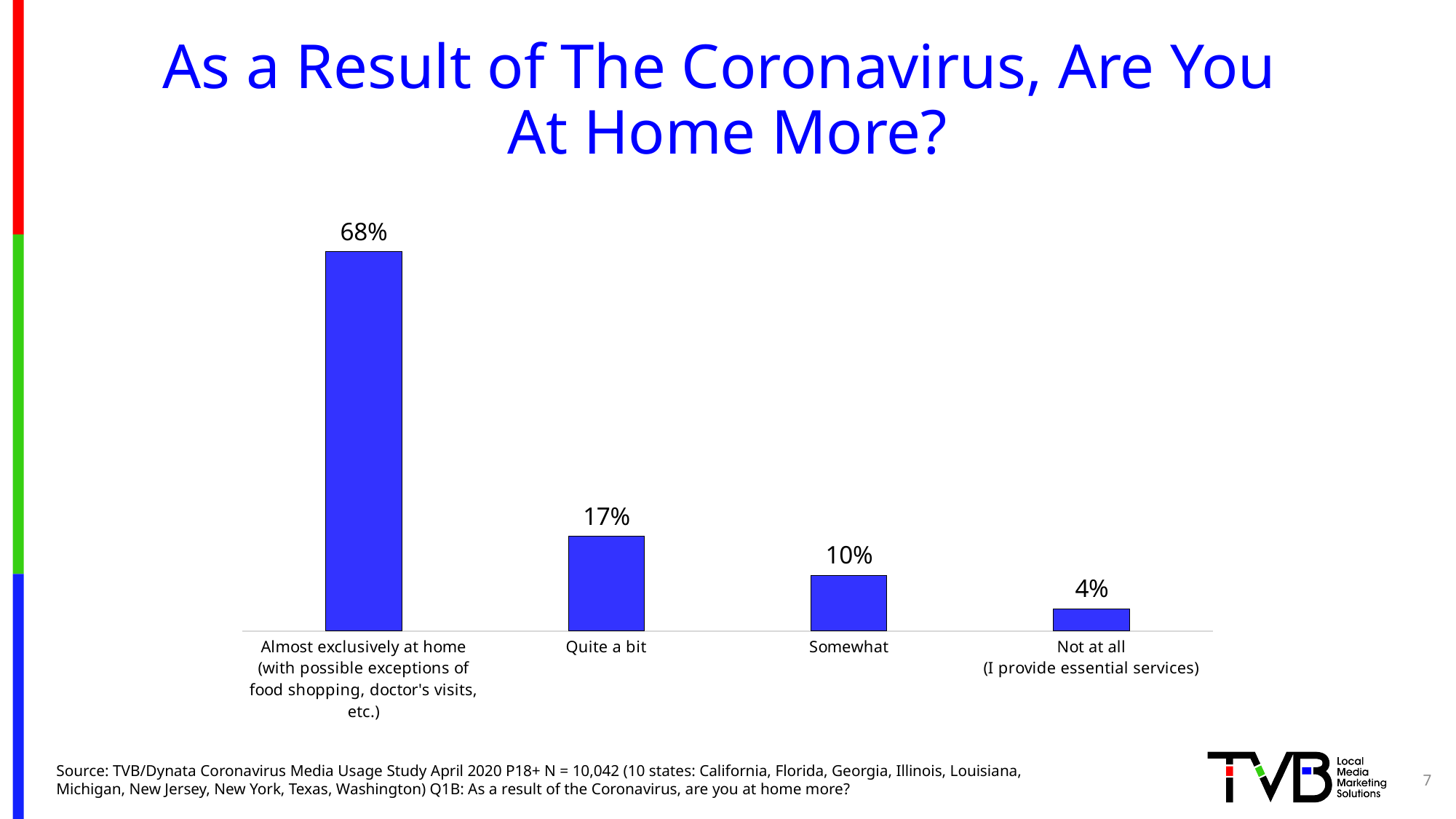
What kind of chart is shown on the slide? Bar chart What percentage of respondents said they are almost exclusively at home? 68% Which is larger, the value for 'Quite a bit' or the value for 'Somewhat'? Quite a bit Which category has the highest value? Almost exclusively at home Do the values rise or fall moving from left to right across the categories? Fall How many categories are shown in the chart? 4 What is the value shown for the 'Quite a bit' category? 17% What percentage of respondents answered 'Not at all (I provide essential services)'? 4% What is the difference between the 'Somewhat' value and the 'Not at all' value? 6% What is the value shown for the 'Somewhat' category? 10% What is the difference between the 'Almost exclusively at home' value and the 'Quite a bit' value? 51% Which category has the lowest value? Not at all (I provide essential services)